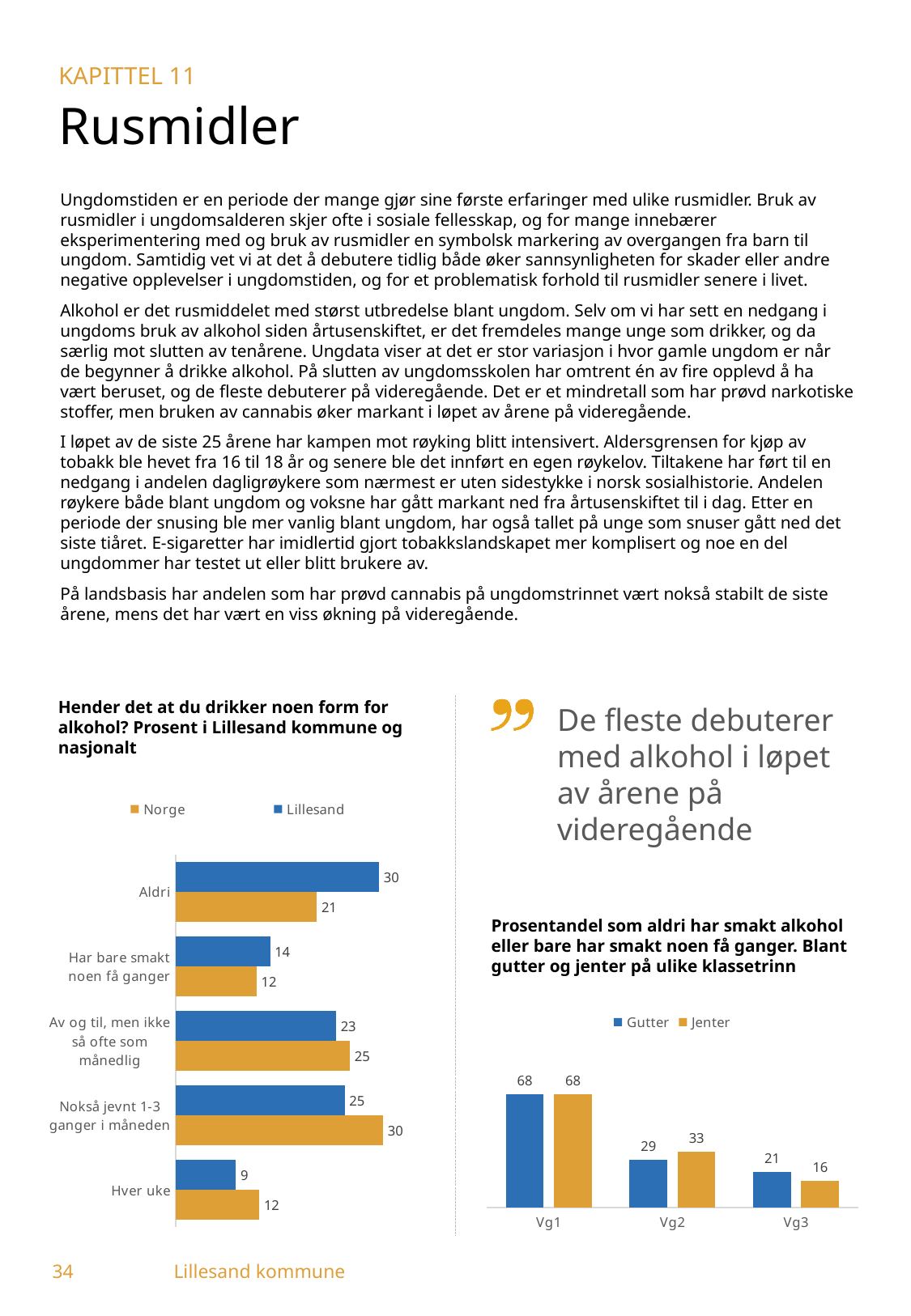
In the chart 'Prosentandel som aldri har smakt alkohol eller bare har smakt noen få ganger', what is the difference between Gutter and Jenter at Vg3? 5 In the chart 'Hender det at du drikker noen form for alkohol?', what is the value for Lillesand in the category 'Aldri'? 30 In the chart 'Hender det at du drikker noen form for alkohol?', which is larger in the category 'Har bare smakt noen få ganger', Norge or Lillesand? Lillesand How many categories are shown in the chart 'Hender det at du drikker noen form for alkohol?'? 5 In the chart 'Hender det at du drikker noen form for alkohol?', what is the difference between Norge and Lillesand in the category 'Nokså jevnt 1-3 ganger i måneden'? 5 How many series does the legend list in the chart 'Hender det at du drikker noen form for alkohol?'? 2 In the chart 'Hender det at du drikker noen form for alkohol?', which category has the lowest value for Lillesand? Hver uke In the chart 'Prosentandel som aldri har smakt alkohol eller bare har smakt noen få ganger', do the values for Gutter rise or fall from Vg1 to Vg3? Fall In the chart 'Hender det at du drikker noen form for alkohol?', what is the value for Norge in the category 'Hver uke'? 12 In the chart 'Prosentandel som aldri har smakt alkohol eller bare har smakt noen få ganger', what is the value for Jenter at Vg2? 33 What kind of chart is 'Prosentandel som aldri har smakt alkohol eller bare har smakt noen få ganger'? Bar chart In the chart 'Prosentandel som aldri har smakt alkohol eller bare har smakt noen få ganger', which colour represents Jenter? Orange